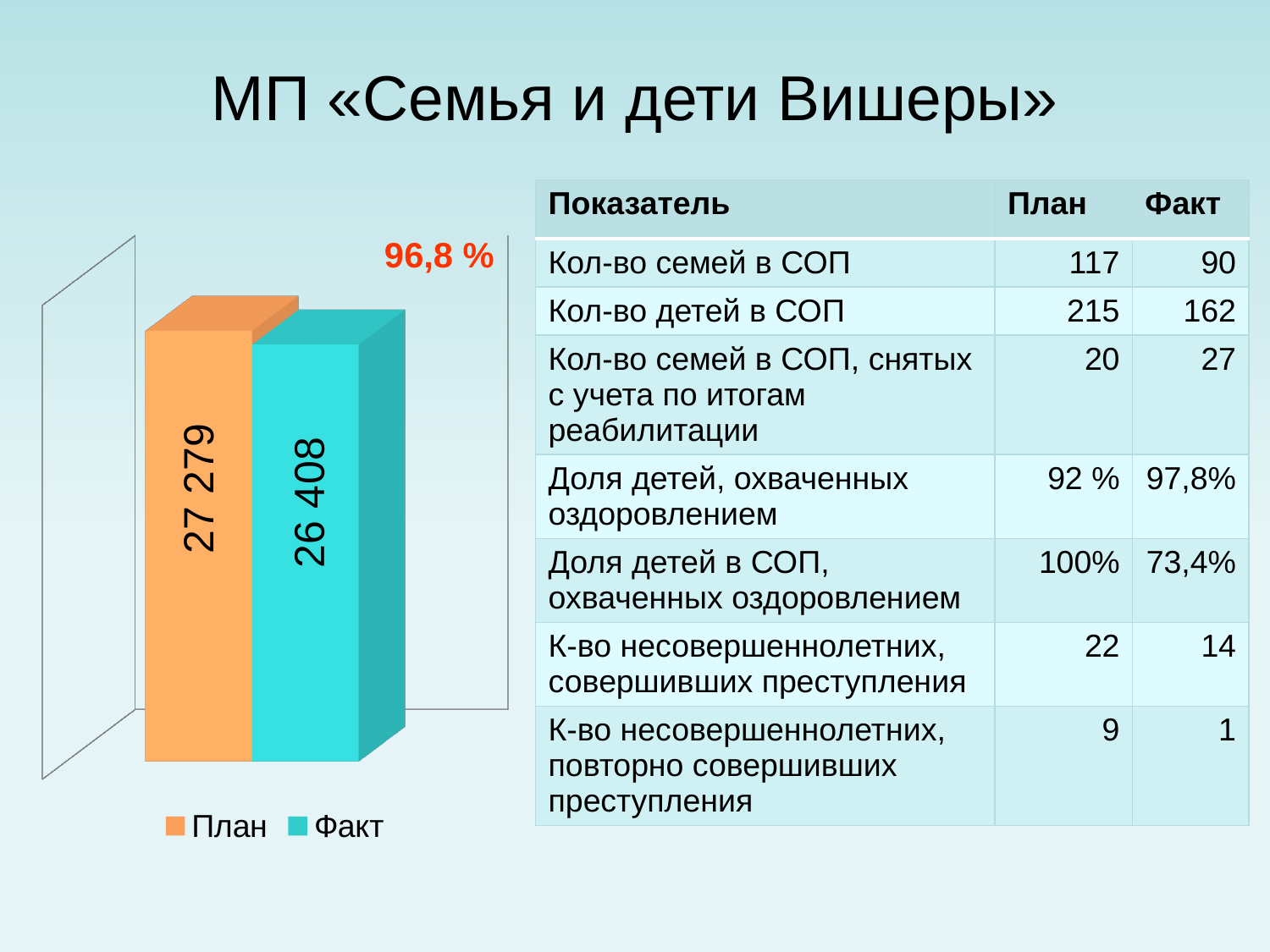
What is the value of the Факт bar in the chart? 26 408 How many series does the chart legend list? 2 What percentage is printed in red above the bars in the chart? 96,8 % How many bars are plotted in the chart? 2 Which series has the lowest value in the chart? Факт What colour is the Факт bar in the chart? Turquoise What is the value of the План bar in the chart? 27 279 Which bar in the chart is higher, План or Факт? План What kind of chart is shown on the left of the slide? Bar chart Which series has the highest value in the chart? План What is the difference between the План and Факт values in the chart? 871